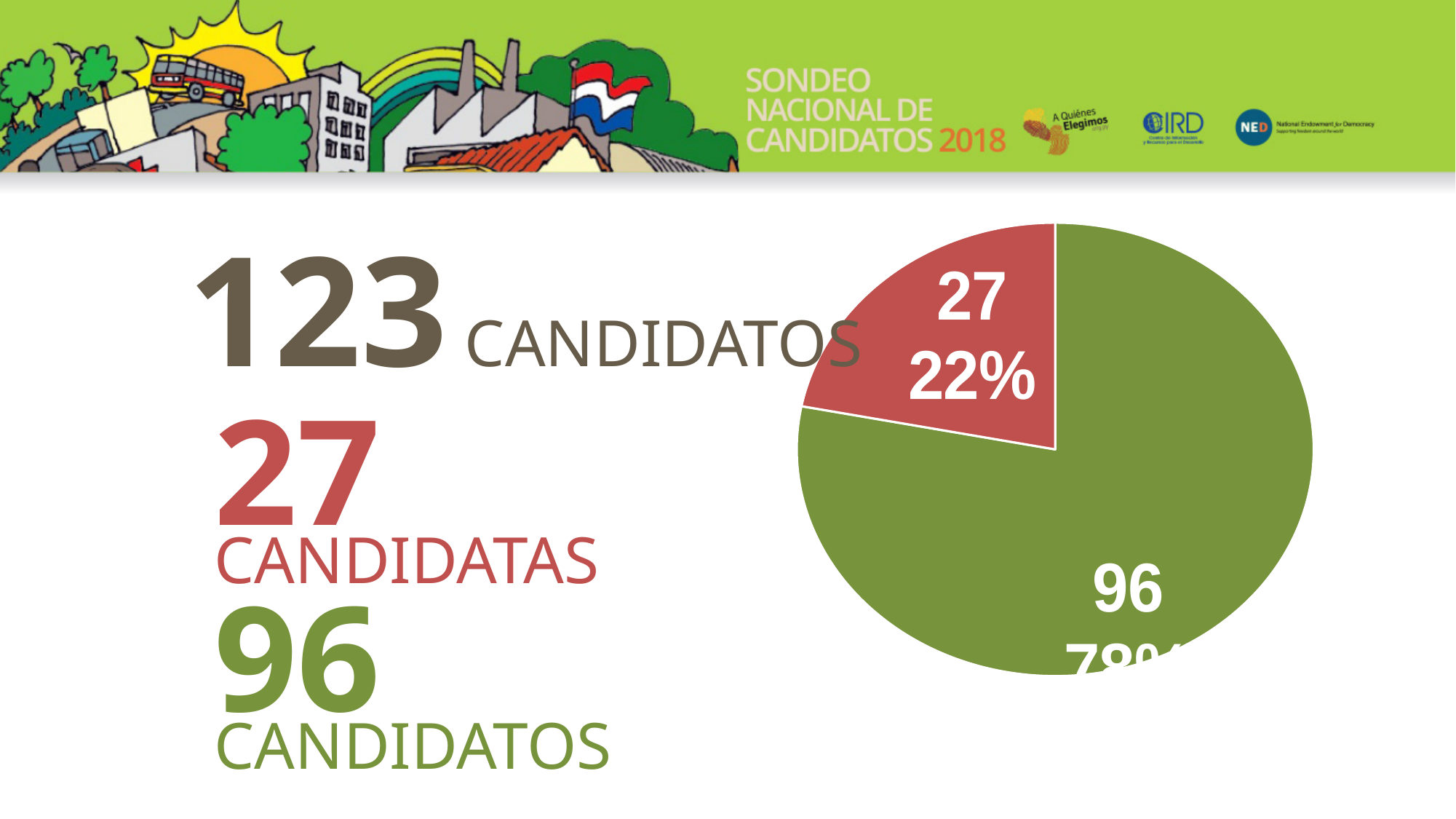
What value is printed on the red slice of the pie chart? 27 What is the difference between the green slice value (96) and the red slice value (27)? 69 What value is printed on the green slice of the pie chart? 96 According to the slide text, how many candidatos in total were surveyed? 123 Which slice of the pie chart is the largest? the green slice (96) What percentage share is printed on the red slice of the pie chart? 22% What colour is the slice representing the 27 candidatas? red Which slice of the pie chart is the smallest? the red slice (27) How many slices does the pie chart have? 2 What kind of chart is shown on the slide? pie chart Which is larger in the pie chart, the red slice or the green slice? the green slice What is the total of the two slice values in the pie chart? 123